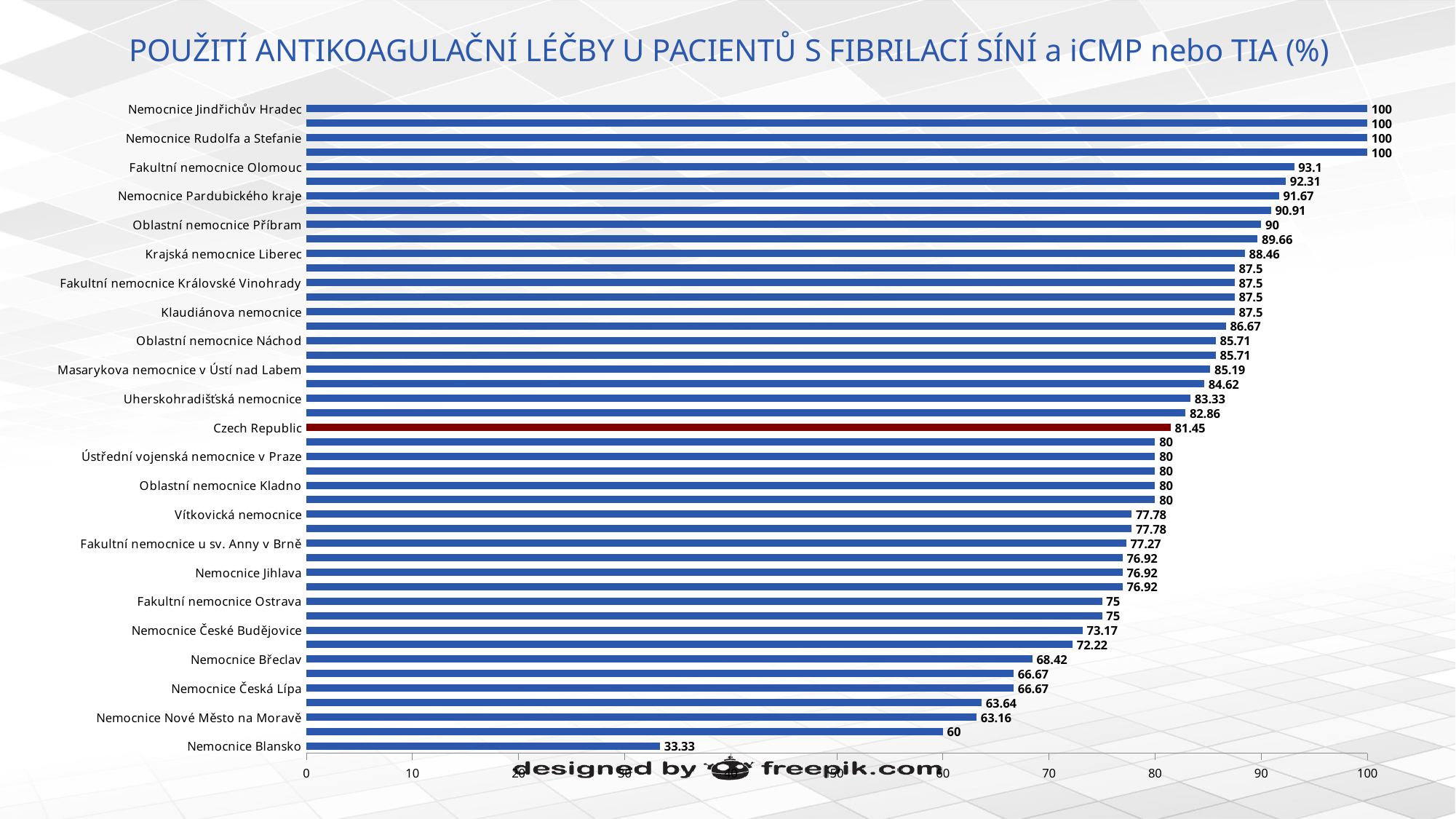
What is the highest value shown on the chart? 100 What is the value for Nemocnice Břeclav? 68.42 What is the value for Czech Republic? 81.45 What is the value for Fakultní nemocnice Olomouc? 93.1 Which is larger, the value for Fakultní nemocnice Olomouc or the value for Fakultní nemocnice Ostrava? Fakultní nemocnice Olomouc Is the value for Nemocnice Nové Město na Moravě greater or less than 70? less What kind of chart is shown on the slide? bar chart What is the difference between the value for Czech Republic and the value for Nemocnice Blansko? 48.12 What is the value for Nemocnice Blansko? 33.33 Which bar is coloured differently (red) from the others? Czech Republic How many bars are plotted on the chart? 45 Which labelled hospital has the lowest value? Nemocnice Blansko